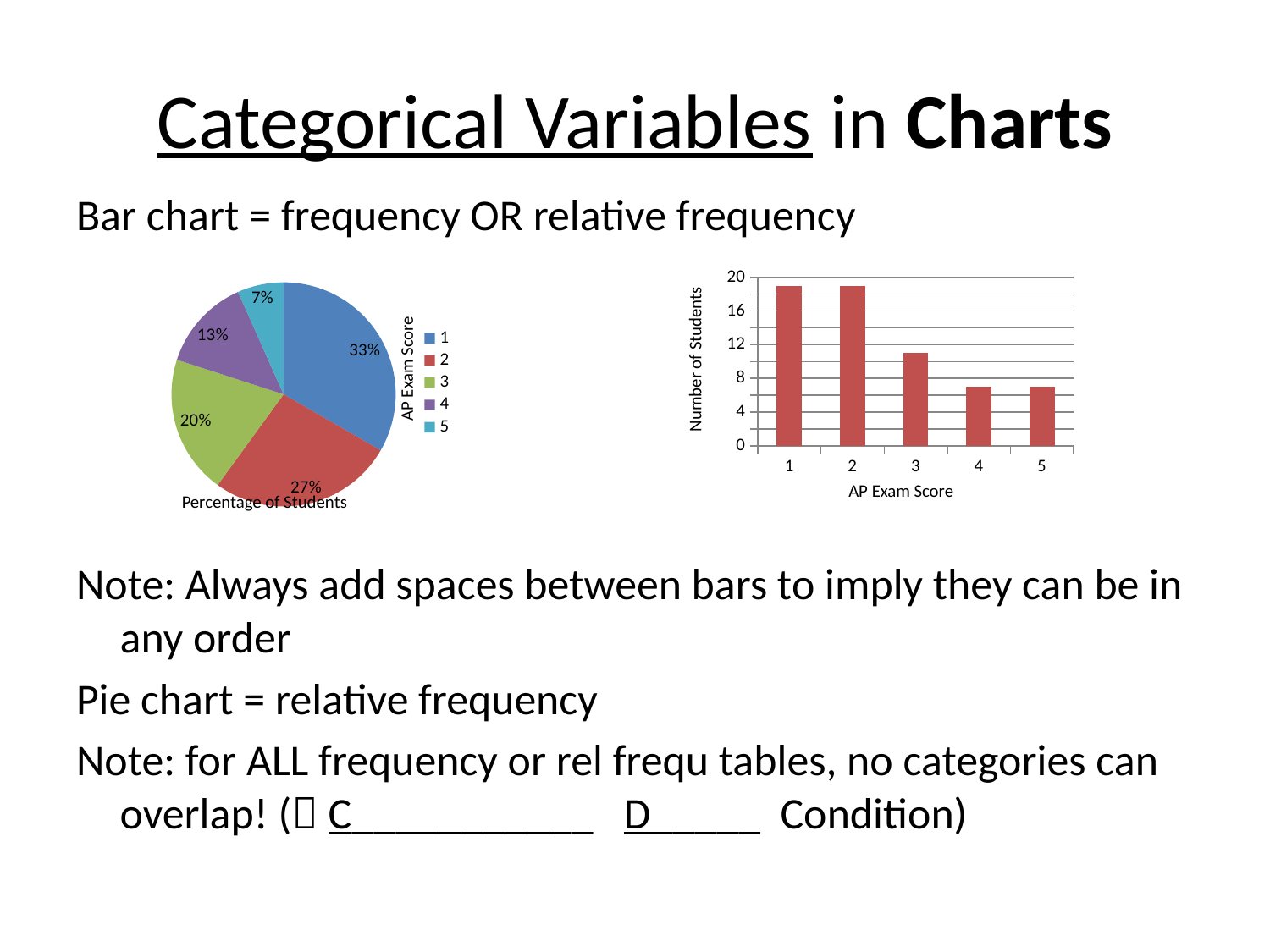
In the pie chart on the left, what is the difference in percentage points between the slices for score 2 and score 4? 14 In the bar chart on the right, is the value for AP exam score 3 greater or less than 8? greater In the bar chart on the right, how many bars are plotted? 5 In the bar chart on the right, what is the label of the vertical axis? Number of Students In the pie chart on the left, which AP exam score has the largest slice? 1 In the bar chart on the right, is the value for AP exam score 4 greater or less than 8? less In the pie chart on the left, what percentage of students scored 1 on the AP exam? 33% In the pie chart on the left, what percentage of students scored 5? 7% In the pie chart on the left, which AP exam score has the smallest slice? 5 In the pie chart on the left, how many categories does the legend list? 5 In the bar chart on the right, is the value for AP exam score 1 greater or less than 16? greater In the pie chart on the left, what percentage of students scored 3? 20%